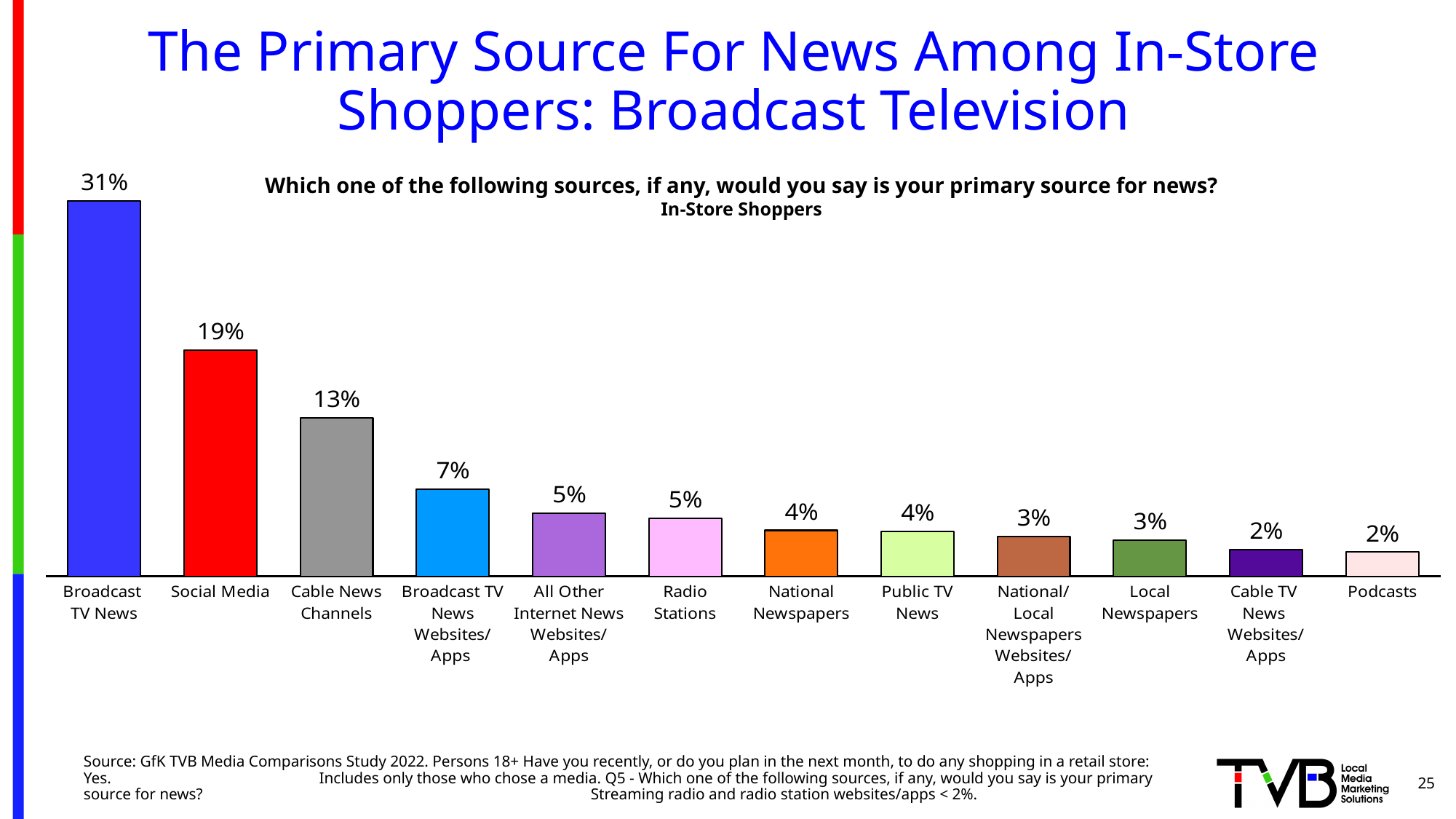
What colour is the bar for Social Media? Red What percentage of in-store shoppers say Broadcast TV News is their primary source for news? 31% What is the value shown for Radio Stations? 5% What kind of chart is shown on the slide? Bar chart What is the value shown for Cable News Channels? 13% What is the difference between the values for Cable News Channels and Broadcast TV News Websites/Apps? 6% Which is larger, the value for National Newspapers or the value for Local Newspapers? National Newspapers What is the value shown for Social Media? 19% Which news source has the highest value in the chart? Broadcast TV News Do the values rise or fall moving from left to right across the chart? Fall What is the difference between the values for Broadcast TV News and Social Media? 12% How many news source categories are shown in the chart? 12